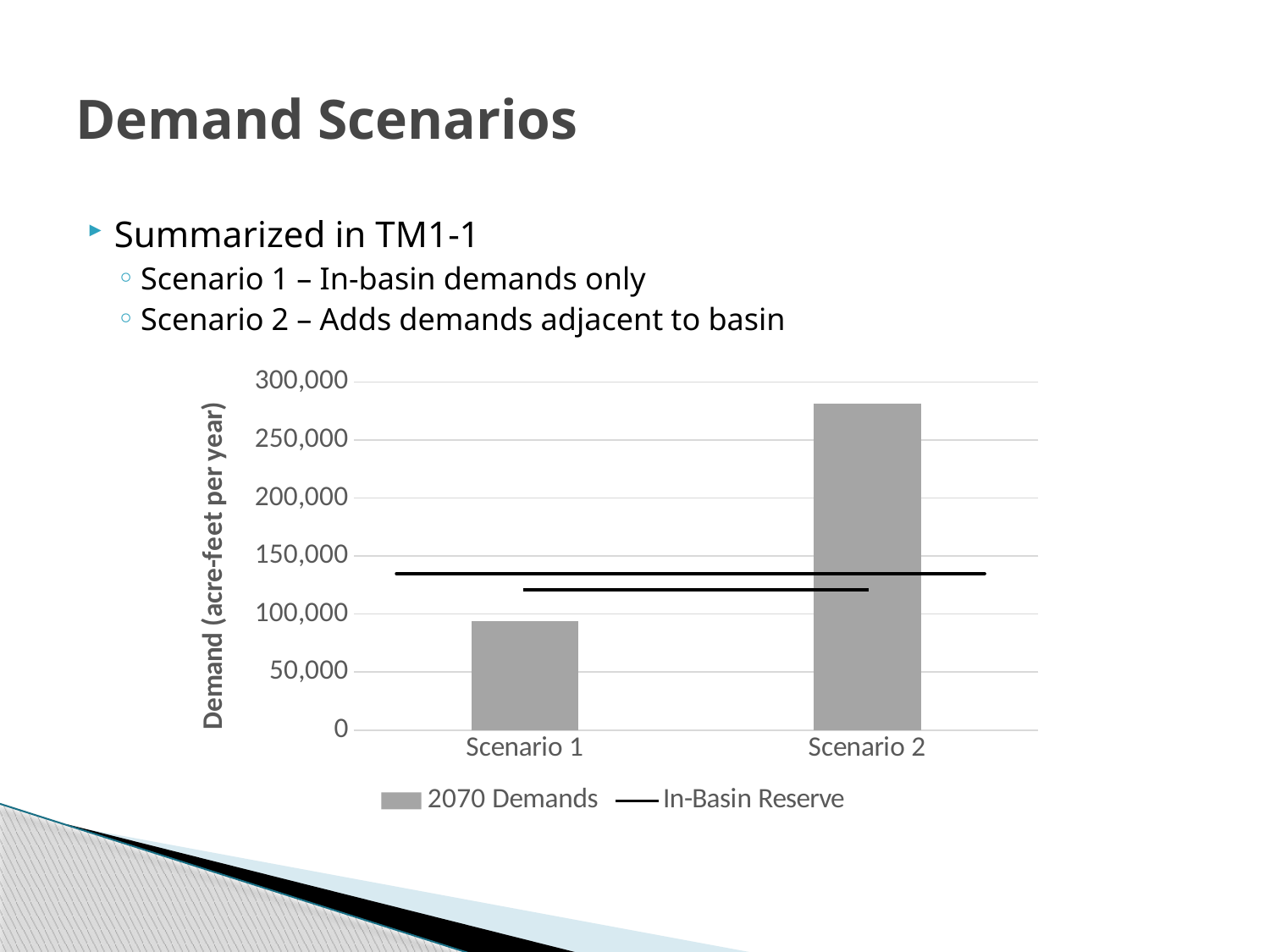
Which is larger, the 2070 Demands for Scenario 1 or for Scenario 2? Scenario 2 What kind of chart is shown on the slide? combination bar and line chart How many scenarios are plotted on the x axis of the chart? 2 Which scenario has the lowest 2070 Demands bar? Scenario 1 Is the 2070 Demands value for Scenario 2 greater or less than 300,000? less Is the 2070 Demands value for Scenario 1 greater or less than 100,000? less Which series in the legend is drawn as a line rather than bars? In-Basin Reserve How many series does the chart legend list? 2 What is the label on the vertical axis of the chart? Demand (acre-feet per year) Is the 2070 Demands value for Scenario 2 greater or less than 250,000? greater Which scenario has the highest 2070 Demands bar? Scenario 2